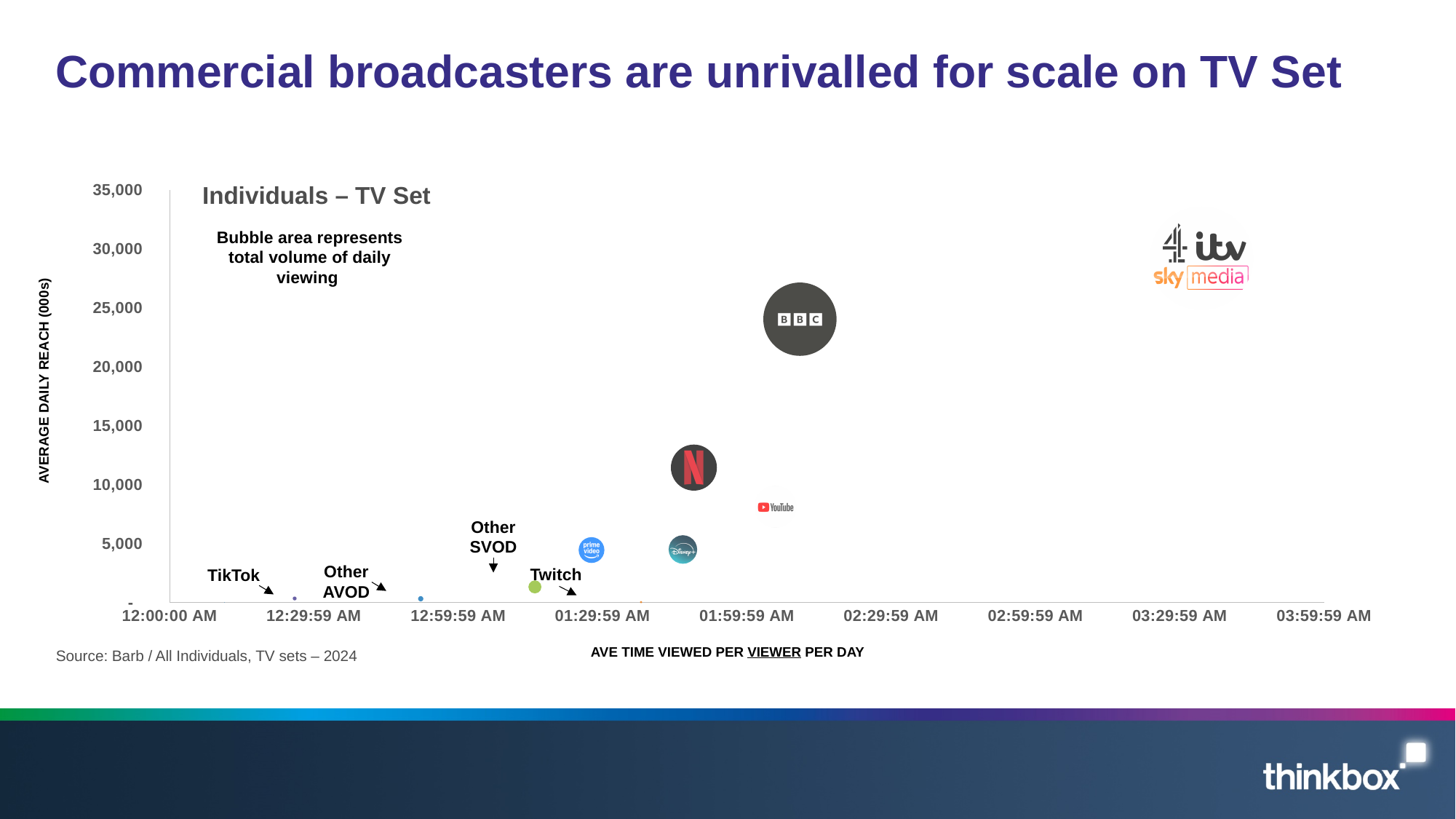
Which has the higher average daily reach, BBC or Netflix? BBC According to the note on the chart, what does the bubble area represent? total volume of daily viewing Is the average daily reach for Netflix greater or less than 10,000? greater What kind of chart is shown on the slide? bubble chart Which has the higher average daily reach, Netflix or YouTube? Netflix Which has the longer average time viewed per viewer per day, YouTube or Netflix? YouTube Is the average daily reach for BBC greater or less than 20,000? greater What is the label on the vertical axis of the chart? AVERAGE DAILY REACH (000s) Is the average daily reach for Twitch greater or less than 5,000? less